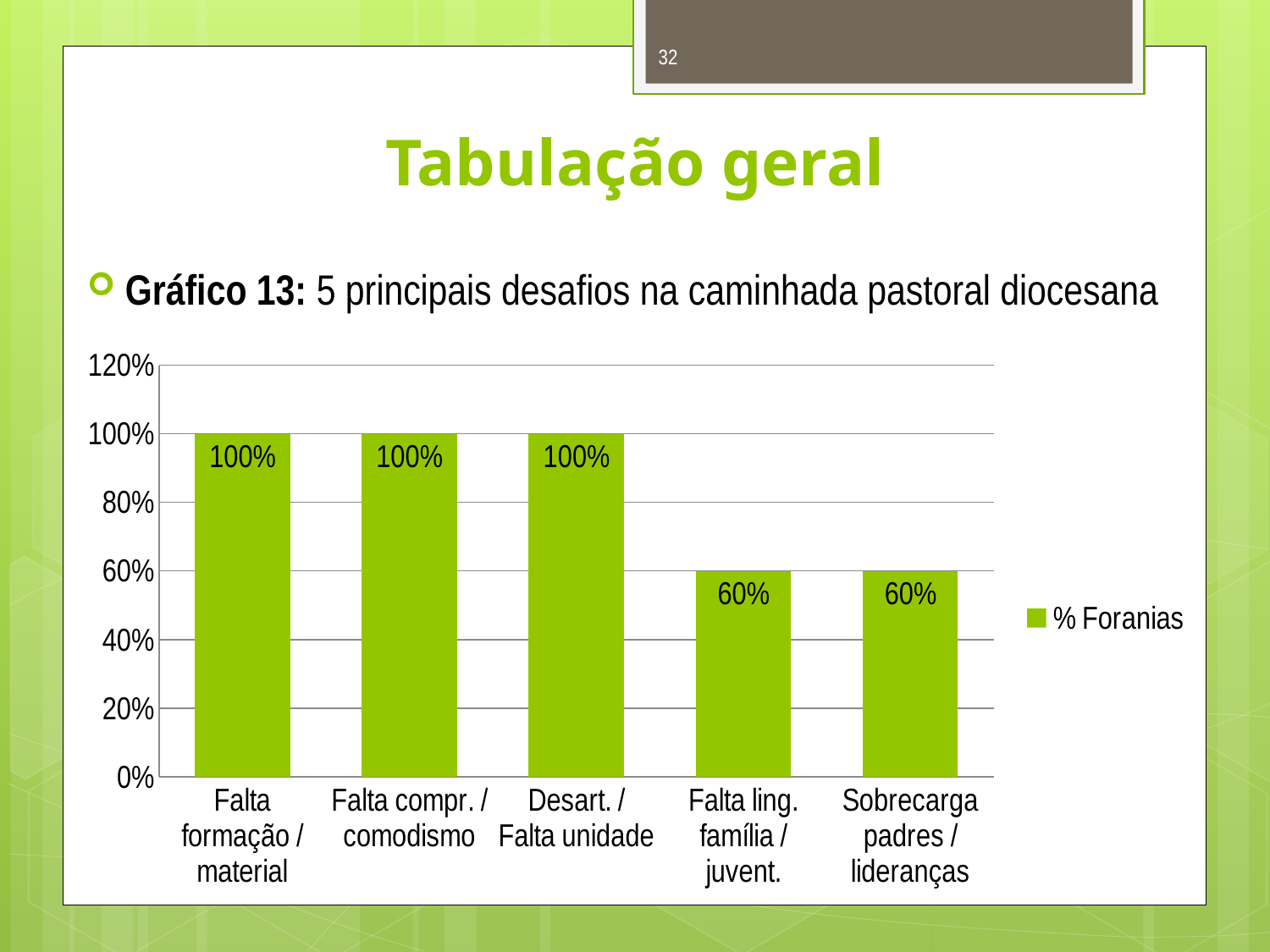
What is the value for "Desart. / Falta unidade"? 100% What is the name of the series shown in the legend? % Foranias How many categories are shown on the x axis? 5 What is the value for "Sobrecarga padres / lideranças"? 60% How many series does the legend list? 1 What is the value for "Falta ling. família / juvent."? 60% Is the value for "Sobrecarga padres / lideranças" greater or less than 80%? less What is the difference between the values for "Falta compr. / comodismo" and "Falta ling. família / juvent."? 40% Which is larger, the value for "Desart. / Falta unidade" or the value for "Sobrecarga padres / lideranças"? Desart. / Falta unidade How many categories have a value of 100%? 3 What is the value for "Falta formação / material"? 100% What kind of chart is shown on the slide? bar chart